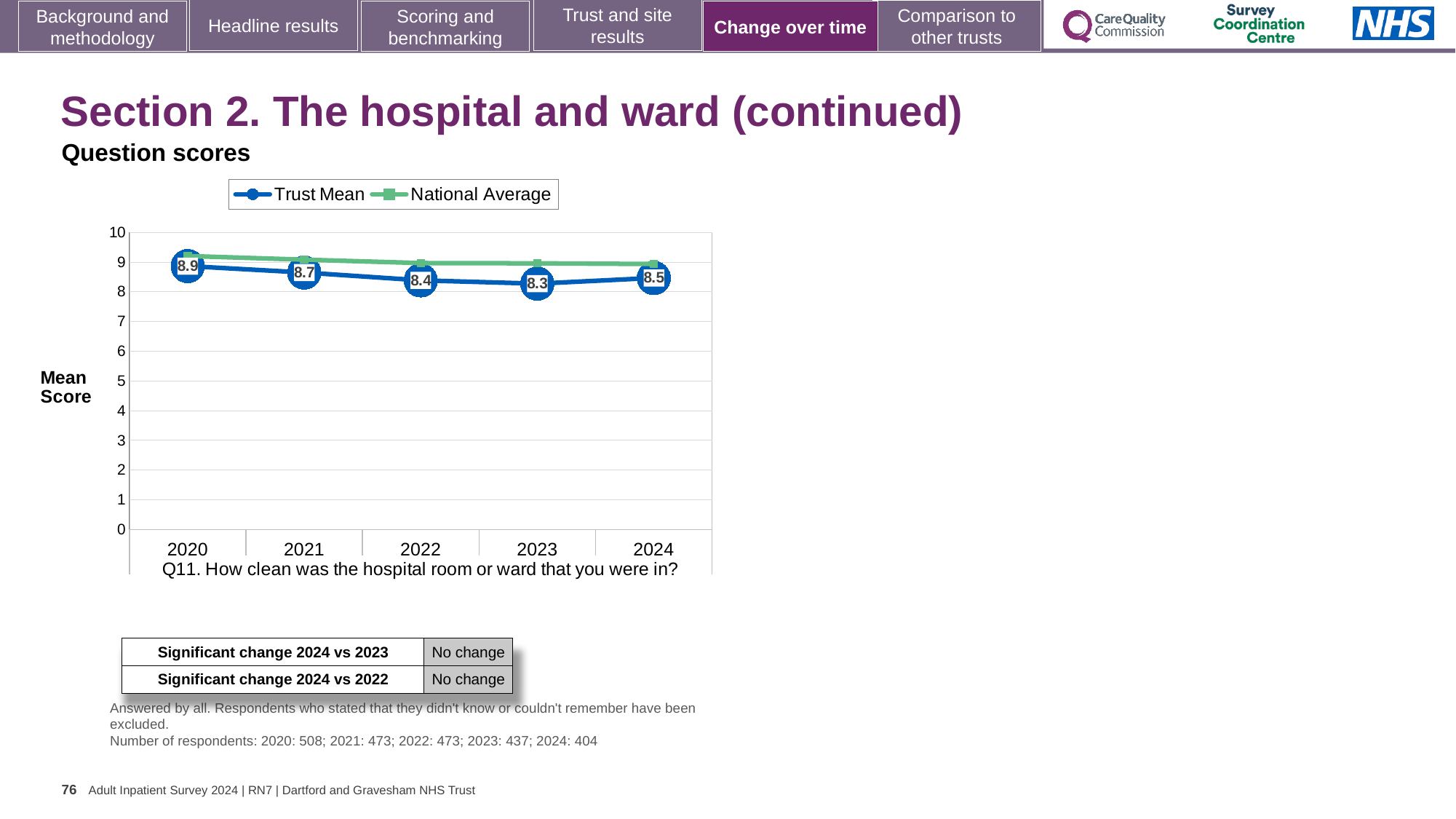
What is the Trust Mean score for 2024? 8.5 What is the Trust Mean score for 2020? 8.9 In which year is the Trust Mean score highest? 2020 Which is larger, the Trust Mean score for 2021 or for 2022? 2021 Is the National Average value for 2020 greater or less than 9? greater How many years are shown on the x axis? 5 How many series does the legend list? 2 What is the difference between the Trust Mean scores for 2020 and 2023? 0.6 What is the Trust Mean score for 2023? 8.3 Which question does the chart relate to, as labelled below the x axis? Q11. How clean was the hospital room or ward that you were in? What kind of chart is shown on the slide? Line chart In which year is the Trust Mean score lowest? 2023